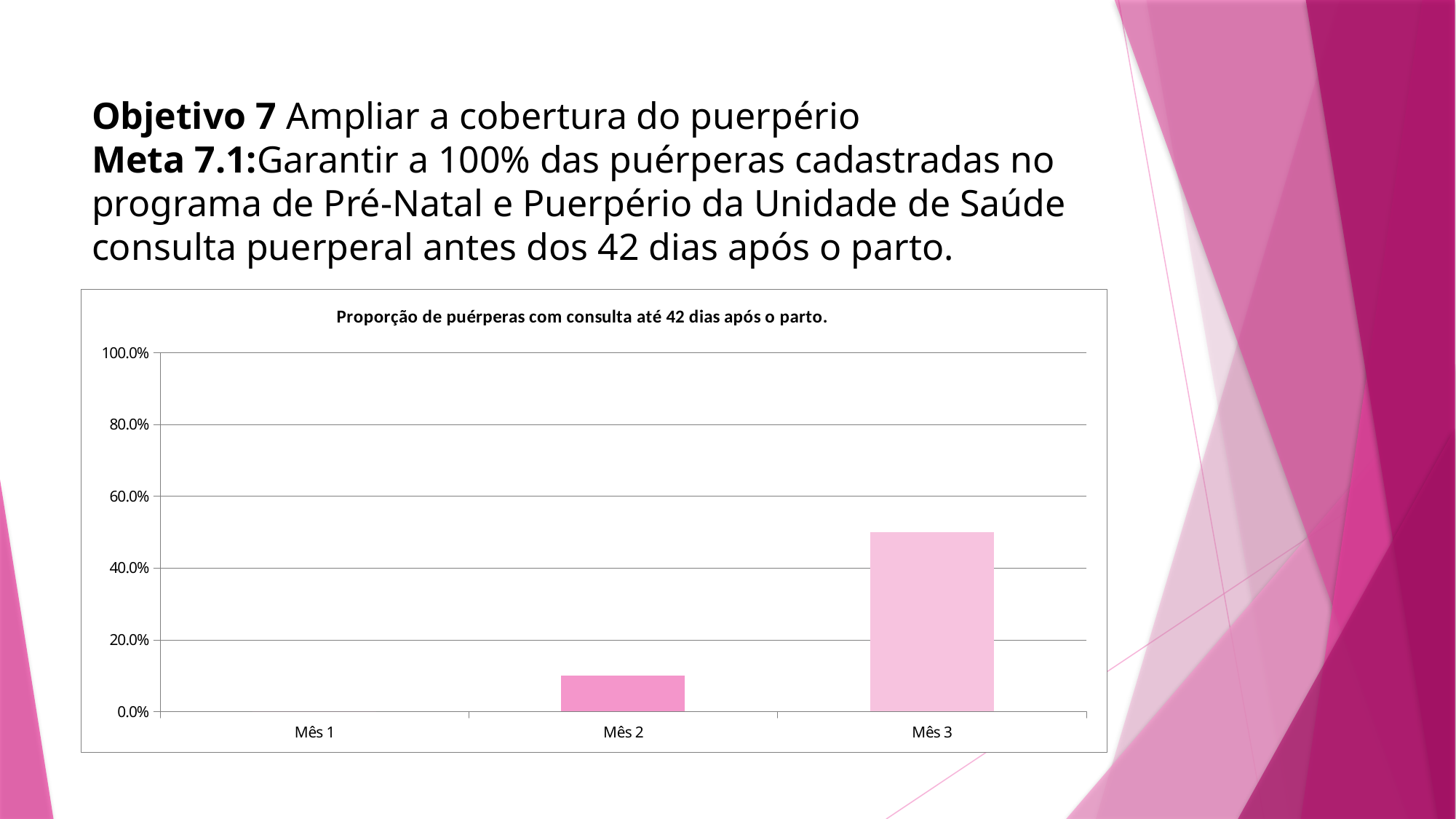
What is the value shown for Mês 1? 0.0% Is the value for Mês 3 greater or less than 40.0%? greater How many categories are shown on the x axis of the chart? 3 Is the value for Mês 2 greater or less than 20.0%? less Is the value for Mês 3 greater or less than 60.0%? less What kind of chart is shown on the slide? bar chart What is the highest tick value shown on the y axis of the chart? 100.0% Do the values rise or fall from Mês 1 to Mês 3? rise Which month has the lowest proportion in the chart? Mês 1 Which has a larger value, Mês 2 or Mês 3? Mês 3 Which month has the highest proportion in the chart? Mês 3 What is the title of the chart? Proporção de puérperas com consulta até 42 dias após o parto.